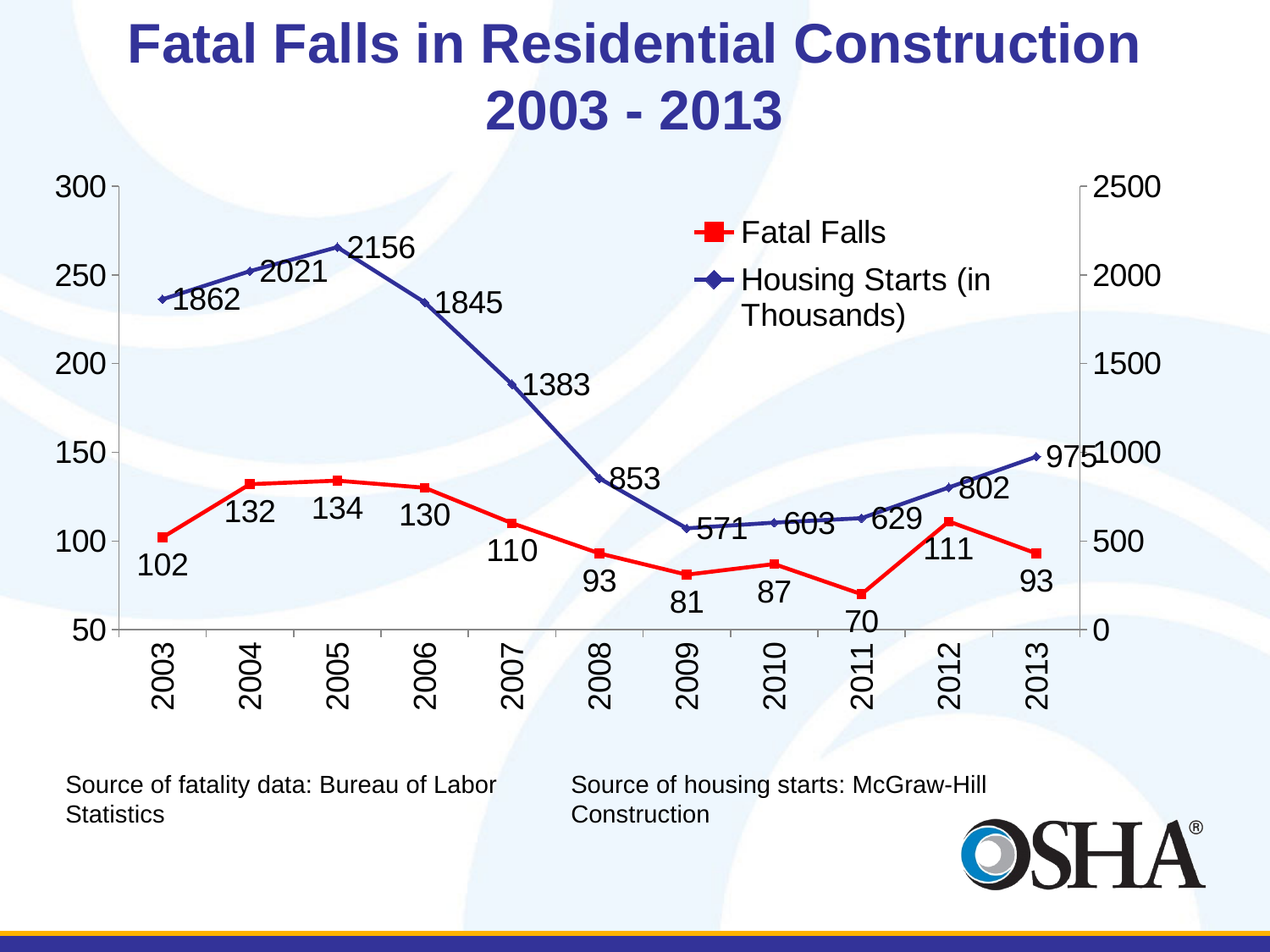
How many years are shown on the x axis? 11 Which year has the larger Fatal Falls value, 2003 or 2013? 2003 In which year is the Fatal Falls value lowest? 2011 What is the difference between the Fatal Falls values in 2012 and 2011? 41 In which year is the Housing Starts (in Thousands) value highest? 2005 What is the value for Housing Starts (in Thousands) in 2009? 571 What colour is the Fatal Falls line? Red What kind of chart is shown on the slide? Line chart How many series does the legend list? 2 Do the Housing Starts (in Thousands) values rise or fall from 2005 to 2009? Fall What is the difference between the Housing Starts (in Thousands) values in 2005 and 2006? 311 What is the value for Fatal Falls in 2005? 134